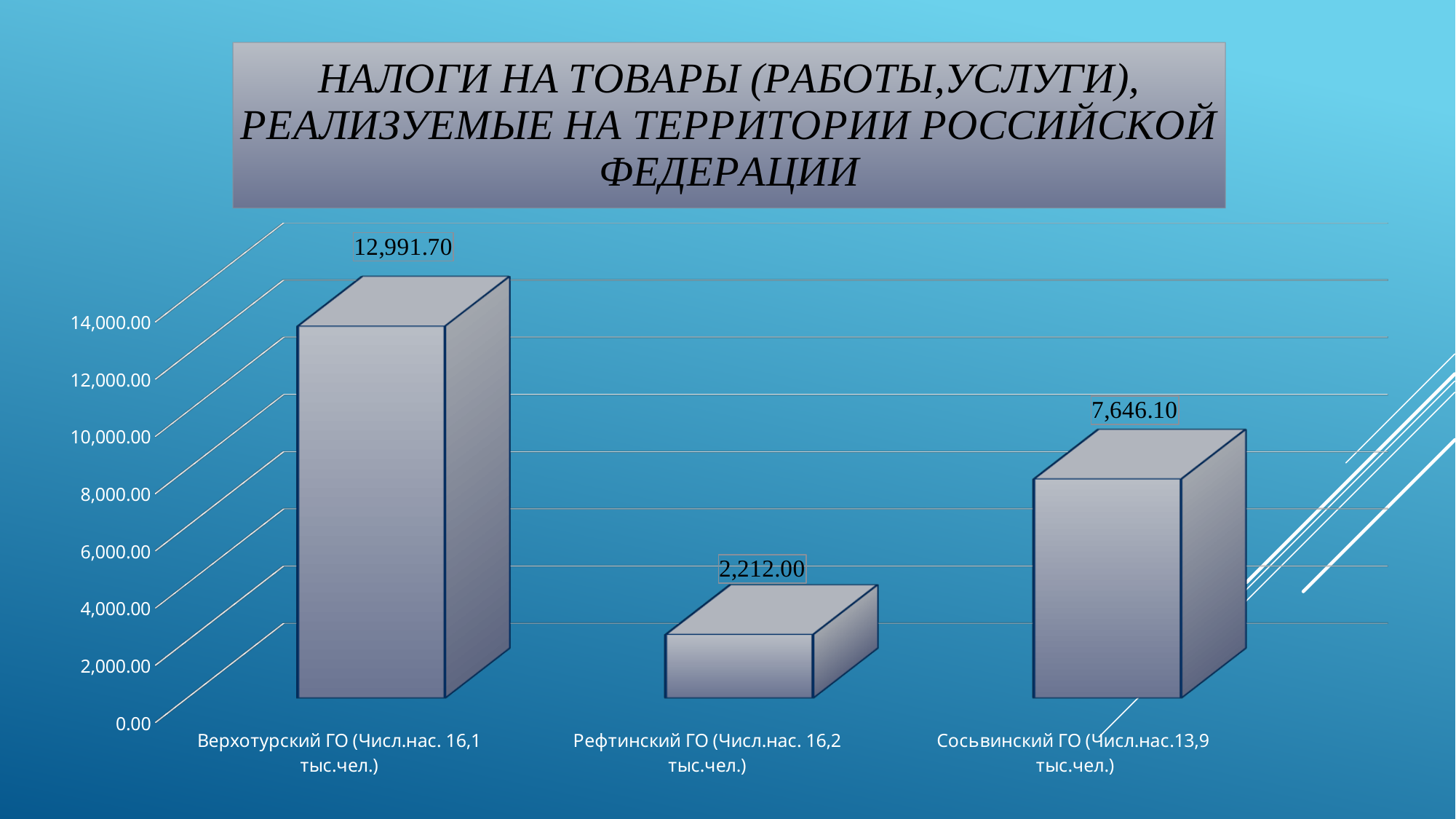
What is the value for Верхотурский ГО? 12,991.70 Which is larger, the value for Сосьвинский ГО or the value for Рефтинский ГО? Сосьвинский ГО Which category has the lowest value? Рефтинский ГО What kind of chart is shown on the slide? bar chart Is the value for Сосьвинский ГО greater or less than 6,000.00? greater What is the title of the chart? НАЛОГИ НА ТОВАРЫ (РАБОТЫ,УСЛУГИ), РЕАЛИЗУЕМЫЕ НА ТЕРРИТОРИИ РОССИЙСКОЙ ФЕДЕРАЦИИ What is the value for Сосьвинский ГО? 7,646.10 What is the value for Рефтинский ГО? 2,212.00 How many categories are shown in the chart? 3 Which category has the highest value? Верхотурский ГО What is the difference between the values for Сосьвинский ГО and Рефтинский ГО? 5,434.10 What is the difference between the values for Верхотурский ГО and Сосьвинский ГО? 5,345.60